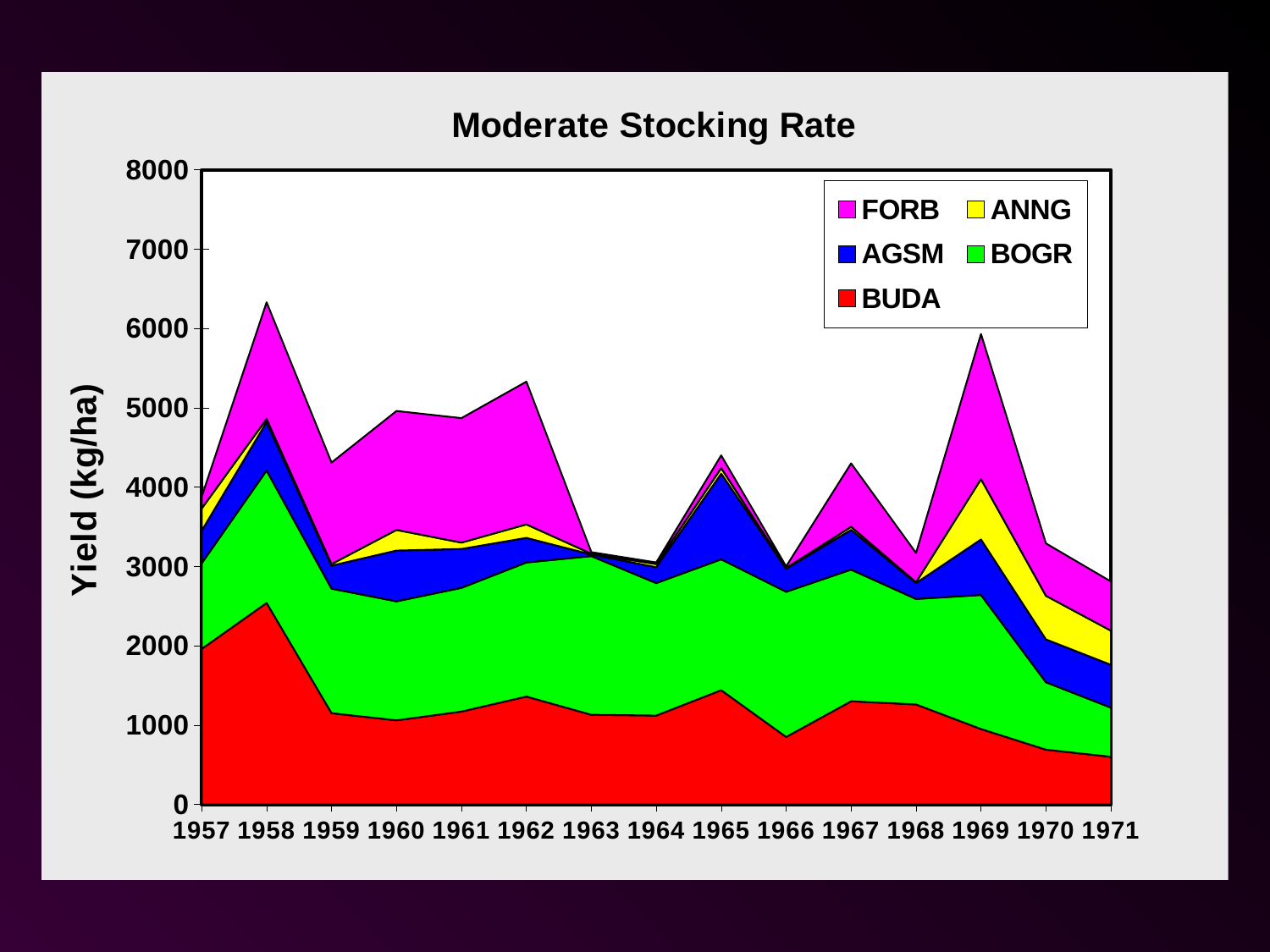
What is the title of the chart? Moderate Stocking Rate What kind of chart is shown on the slide? Stacked area chart In which year is the BUDA yield highest? 1958 Which year has the larger total stacked yield, 1958 or 1962? 1958 Is the total stacked yield in 1958 greater or less than 6000? greater Does the BUDA yield rise or fall from 1968 to 1971? fall Is the total stacked yield in 1969 greater or less than 5000? greater In which year is the total stacked yield highest? 1958 What is the label on the y axis? Yield (kg/ha) How many years are shown along the x axis? 15 How many series does the legend list? 5 Is the BUDA yield in 1966 greater or less than 1000? less